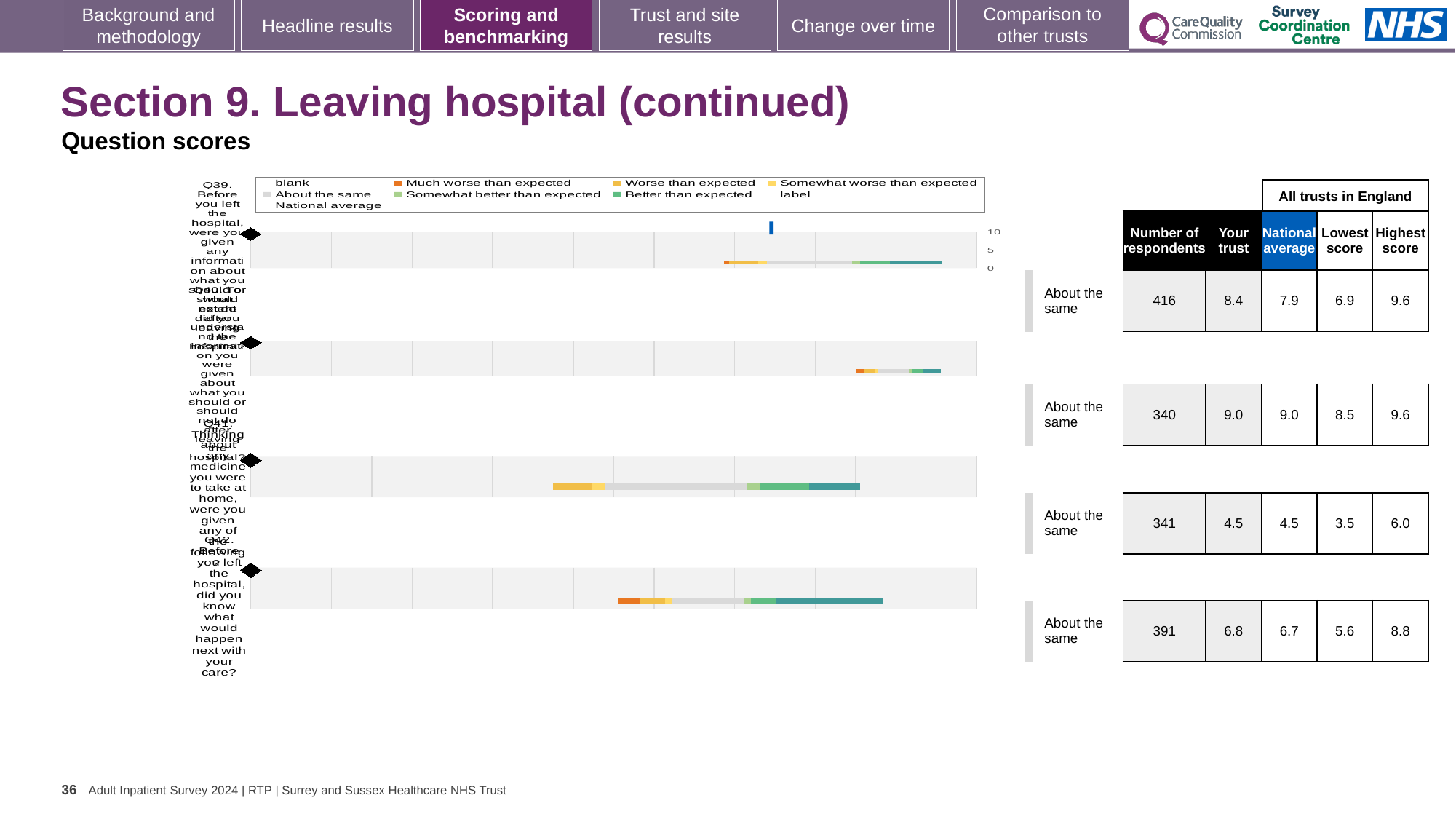
Which question has the highest 'Your trust' score? Q40 What kind of chart is shown on the slide? bar chart How many respondents answered Q39, the first question on the chart? 416 How many questions (bars) are plotted on the chart? 4 What is the 'Your trust' score for Q42 (Before you left the hospital, did you know what would happen next with your care?)? 6.8 What is the national average score for Q41, the third question on the chart? 4.5 What is the difference between the trust score and the national average for Q39? 0.5 Which question has the lowest 'Your trust' score? Q41 What is the highest value shown on the chart's score axis? 10 What benchmark category is shown for all four questions on the chart? About the same What is the highest score among all trusts in England for Q40, the second question on the chart? 9.6 For Q42, which is larger: the trust score or the national average? the trust score